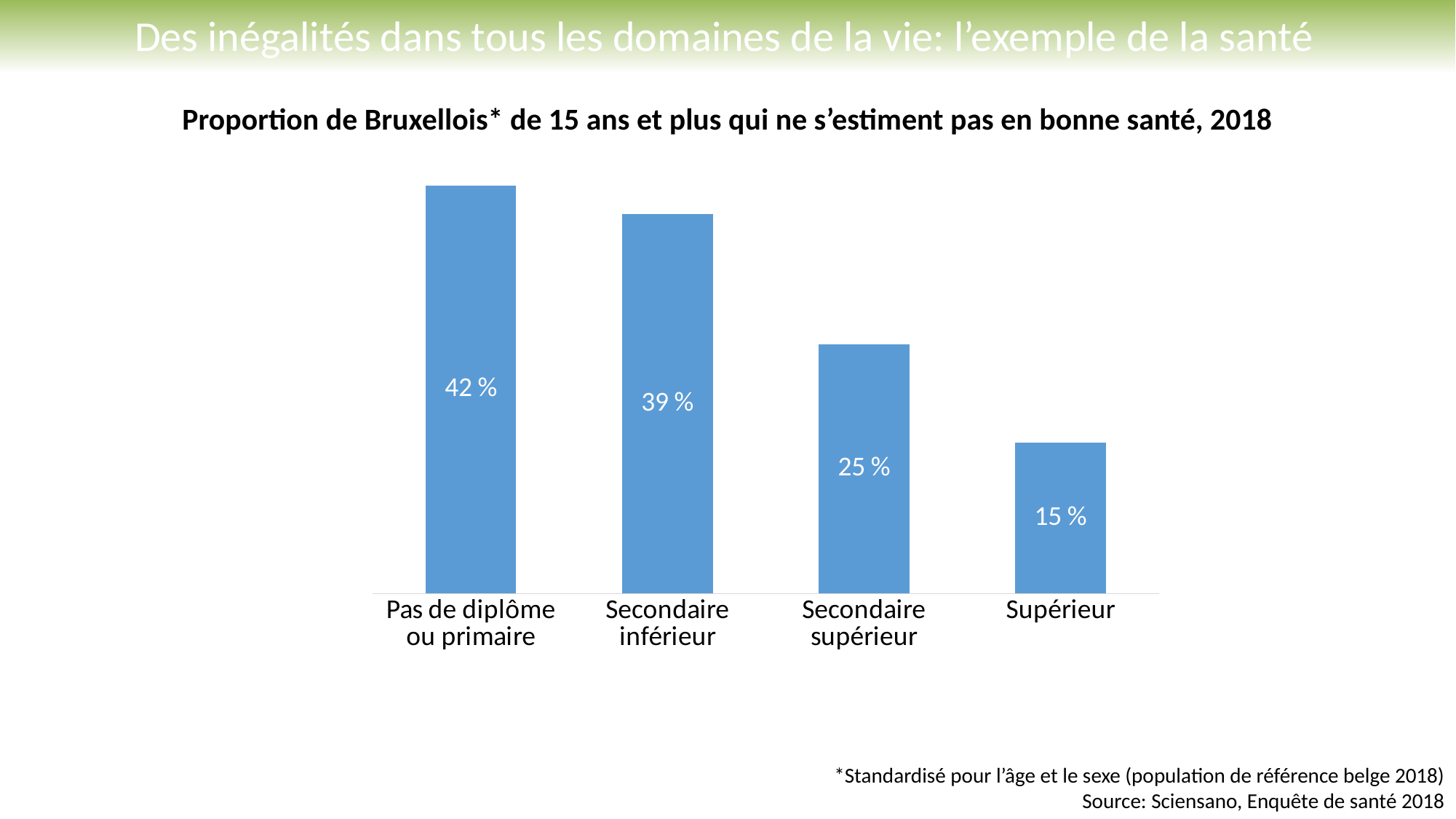
How many categories are shown in the chart? 4 Which is larger, the value for 'Secondaire supérieur' or the value for 'Supérieur'? Secondaire supérieur Which category has the lowest value? Supérieur What kind of chart is shown on the slide? Bar chart Which category has the highest value? Pas de diplôme ou primaire What is the value for 'Secondaire supérieur'? 25 % What is the value for 'Secondaire inférieur'? 39 % What is the difference between the values for 'Secondaire inférieur' and 'Secondaire supérieur'? 14 % What is the difference between the values for 'Pas de diplôme ou primaire' and 'Supérieur'? 27 % What is the value for 'Pas de diplôme ou primaire'? 42 % Do the values rise or fall from left to right along the x axis? Fall What is the value for 'Supérieur'? 15 %